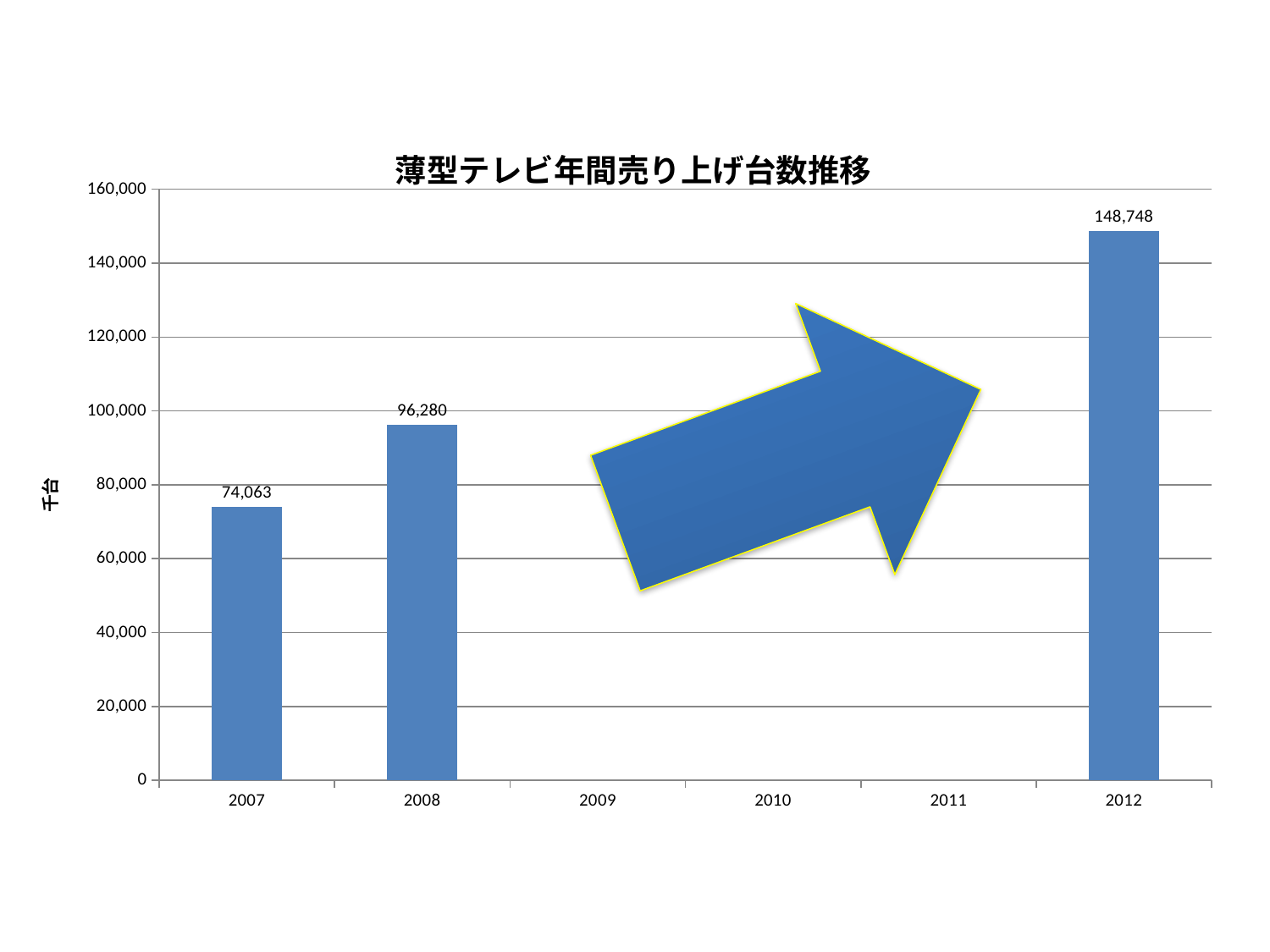
What is the difference between the values for 2008 and 2007? 22,217 What is the title of the chart? 薄型テレビ年間売り上げ台数推移 What is the value for 2007? 74,063 What is the value for 2012? 148,748 What is the value for 2008? 96,280 What is the difference between the values for 2012 and 2007? 74,685 Is the value for 2012 greater or less than 140,000? greater What kind of chart is shown? bar chart Which year has the highest value? 2012 How many years are labelled on the x axis? 6 Which is larger, the value for 2008 or the value for 2012? 2012 Among the years with a bar shown, which has the lowest value? 2007